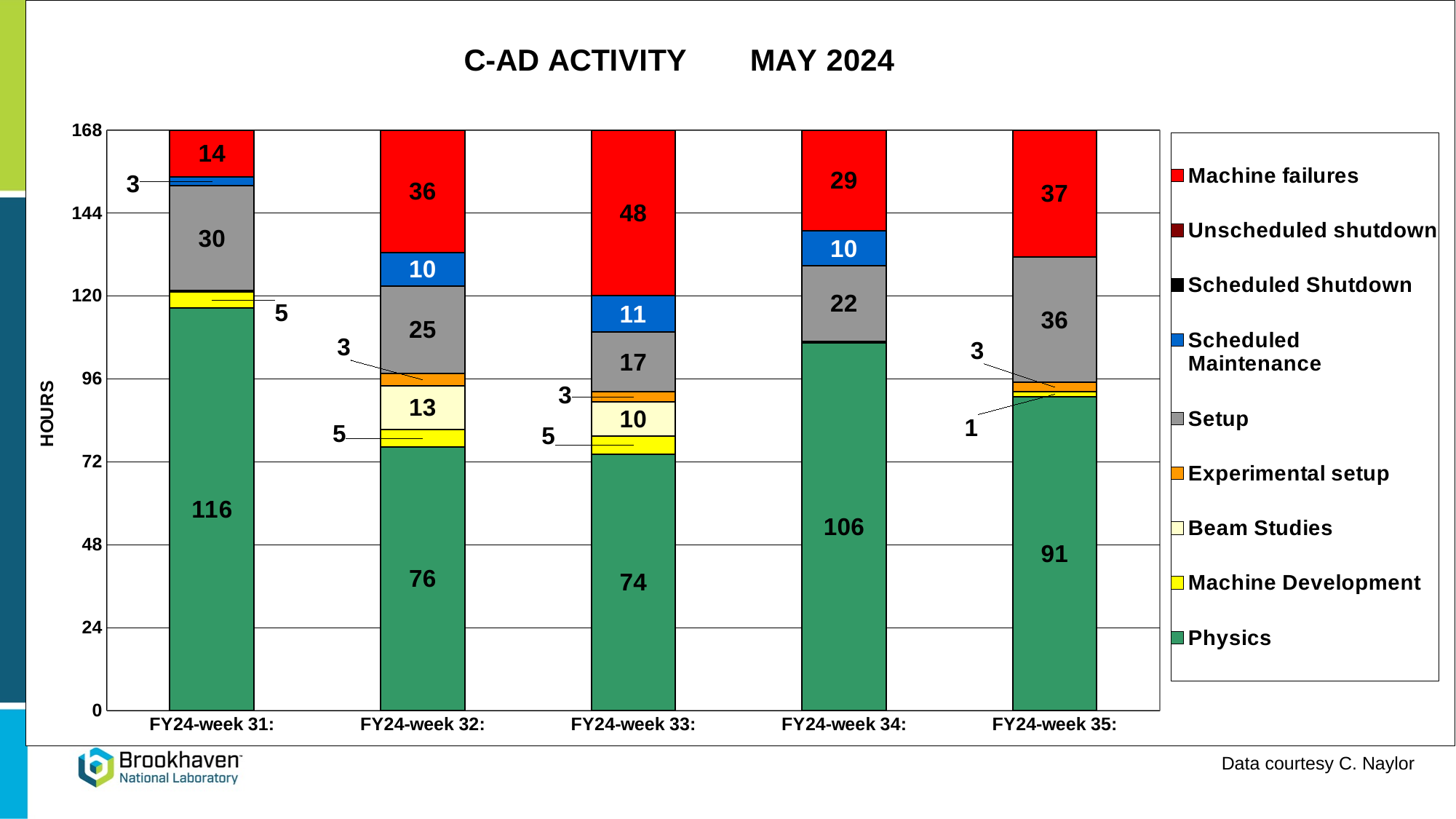
What is the Beam Studies value for FY24-week 32? 13 What is the Machine failures value for FY24-week 33? 48 What is the difference between the Physics hours in FY24-week 31 and FY24-week 34? 10 Which week has the lowest Physics value? FY24-week 33 Which week has the highest Machine failures value? FY24-week 33 How many hours of Physics are shown for FY24-week 31? 116 How many series does the legend list? 9 How many weeks are shown on the x axis? 5 What kind of chart is shown on the slide? Stacked bar chart What is the Scheduled Maintenance value for FY24-week 33? 11 Which week has the larger Setup value, FY24-week 31 or FY24-week 35? FY24-week 35 What is the label of the y axis? HOURS